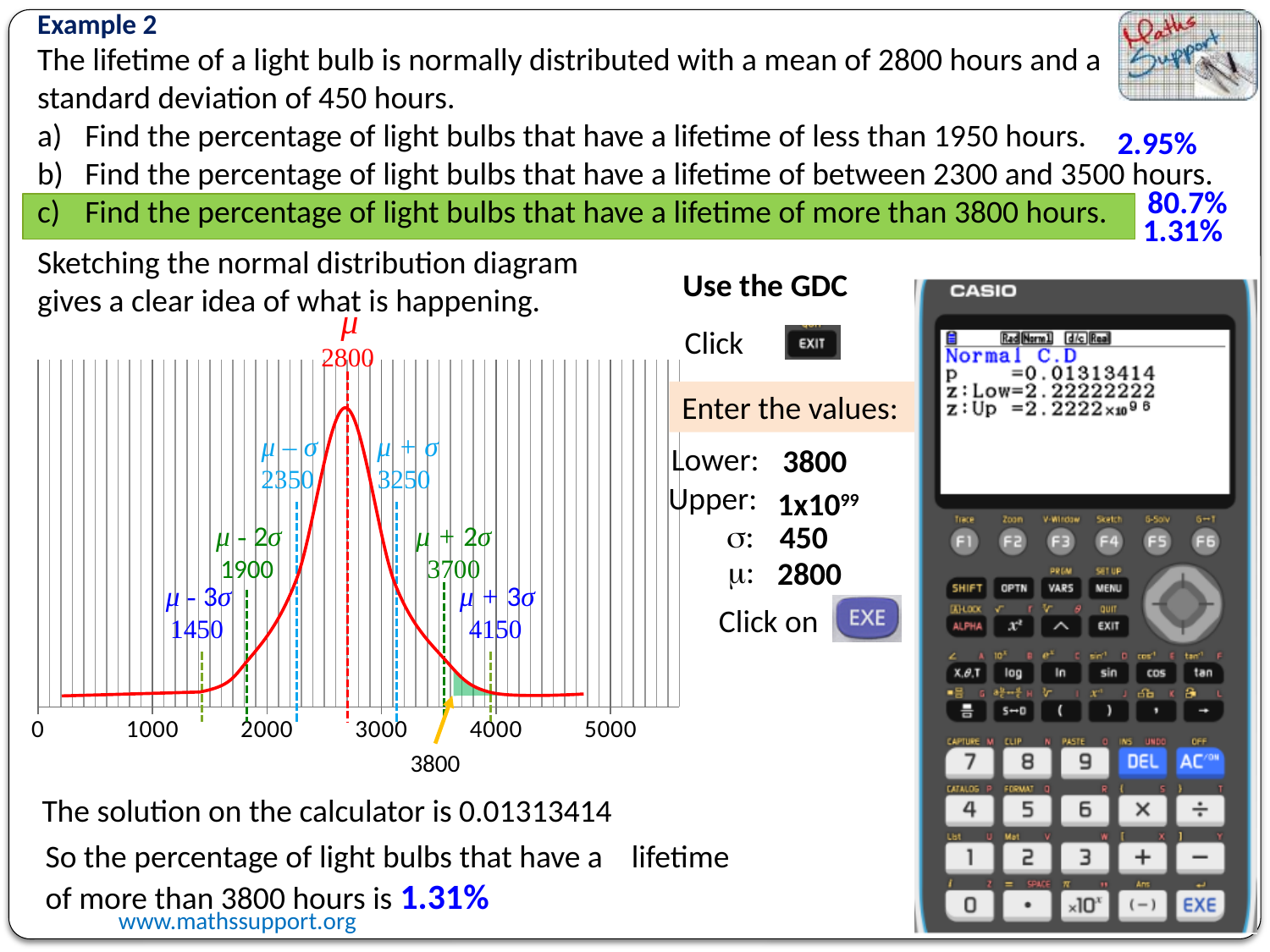
What is the difference between the values labelled at μ + σ and μ − σ on the diagram? 900 What value is labelled at μ − σ on the normal distribution diagram? 2350 What is the largest value printed on the x axis of the normal distribution diagram? 5000 What value is labelled at μ − 3σ on the normal distribution diagram? 1450 What value is labelled at μ + σ on the normal distribution diagram? 3250 What x value does the arrow below the diagram point to, marking the start of the shaded region? 3800 What value is labelled at μ + 2σ on the normal distribution diagram? 3700 What kind of chart is the normal distribution diagram? line chart What value is labelled at μ + 3σ on the normal distribution diagram? 4150 Is the value labelled at μ + 2σ greater or less than 3000 on the x axis? greater What value is labelled at the mean μ on the normal distribution diagram? 2800 Which is larger on the diagram, the value at μ + 2σ or the value at μ − 2σ? μ + 2σ